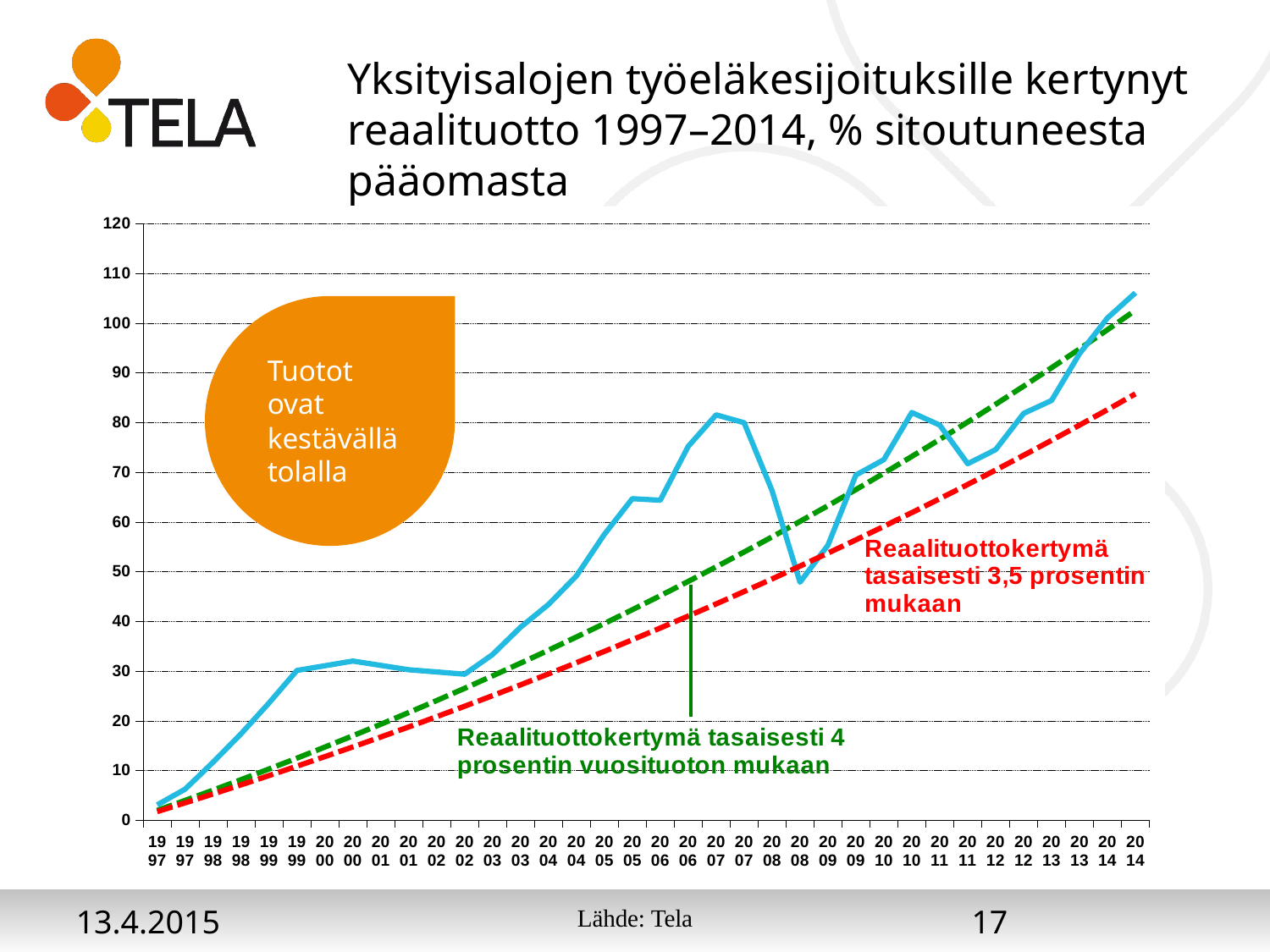
What is the highest value shown on the y axis of the chart? 120 Is the value of the solid blue line at the first point (1997) greater or less than 10? less What kind of chart is shown on the slide? line chart According to the annotation, what annual return does the green dashed line represent? 4 prosentin vuosituoton mukaan At the last point (2014), which is higher: the green dashed line or the red dashed line? the green dashed line How many distinct years are labelled on the x axis of the chart? 18 Is the value of the solid blue line at the first 2007 point greater or less than 70? greater Is the value of the red dashed line at the last point (2014) greater or less than 90? less At the first 2007 point, which is higher: the solid blue line or the green dashed line? the solid blue line Overall, does the solid blue line rise or fall from 1997 to 2014? rise How many lines are plotted on the chart? 3